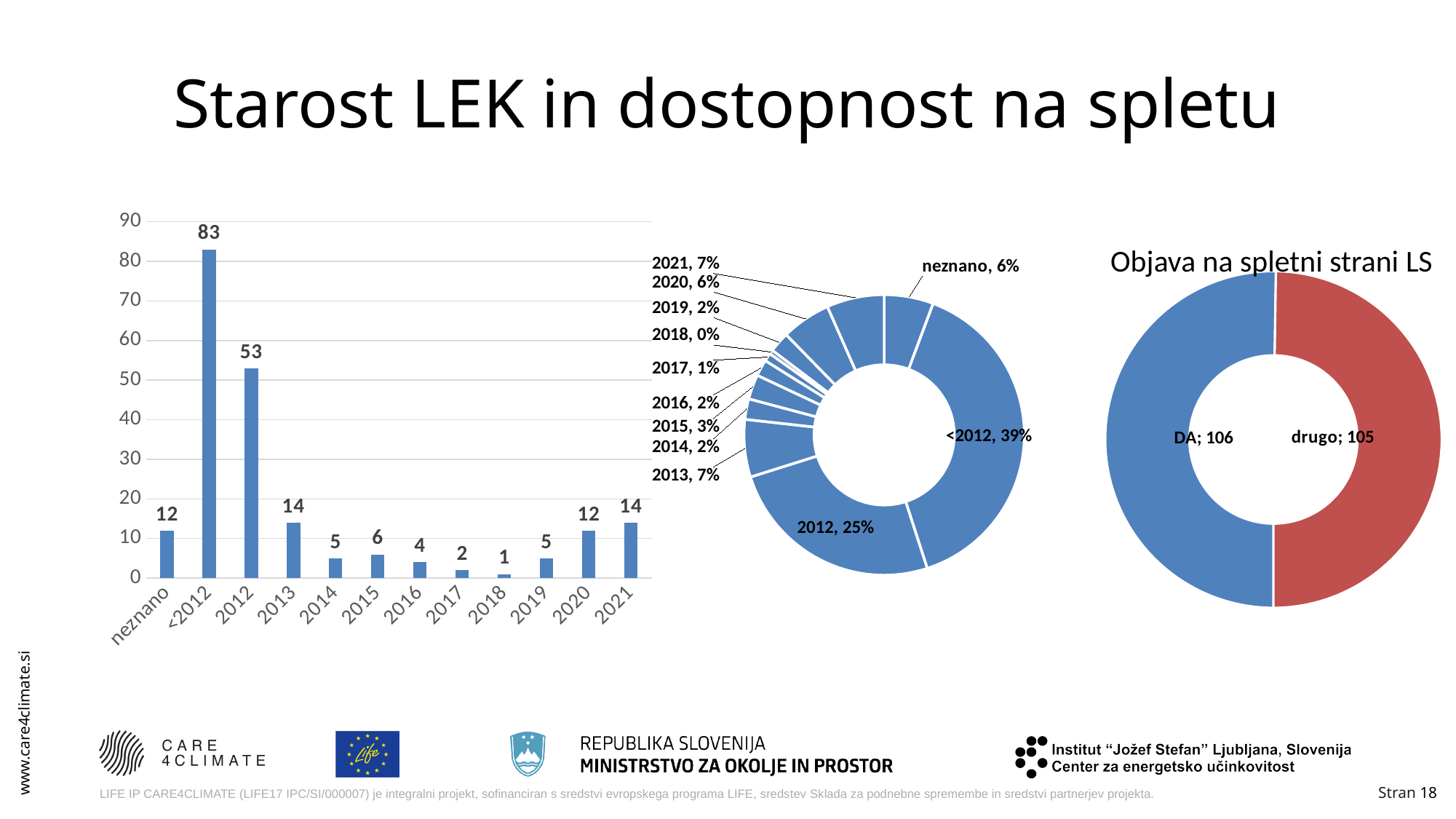
In the doughnut chart in the middle of the slide, what share does <2012 have? 39% In the bar chart on the left, what is the difference between the values for <2012 and 2012? 30 In the chart titled 'Objava na spletni strani LS', what is the difference between DA and drugo? 1 In the bar chart on the left, which category has the lowest value? 2018 In the bar chart on the left, what is the value for 2012? 53 What kind of chart is the chart on the left of the slide? bar chart In the doughnut chart in the middle of the slide, what share does 2012 have? 25% In the bar chart on the left, what is the value for <2012? 83 In the chart titled 'Objava na spletni strani LS', what is the value for DA? 106 In the bar chart on the left, which category has the highest value? <2012 In the bar chart on the left, which is larger, the value for 2014 or the value for 2015? 2015 How many categories are shown on the x axis of the bar chart on the left? 12